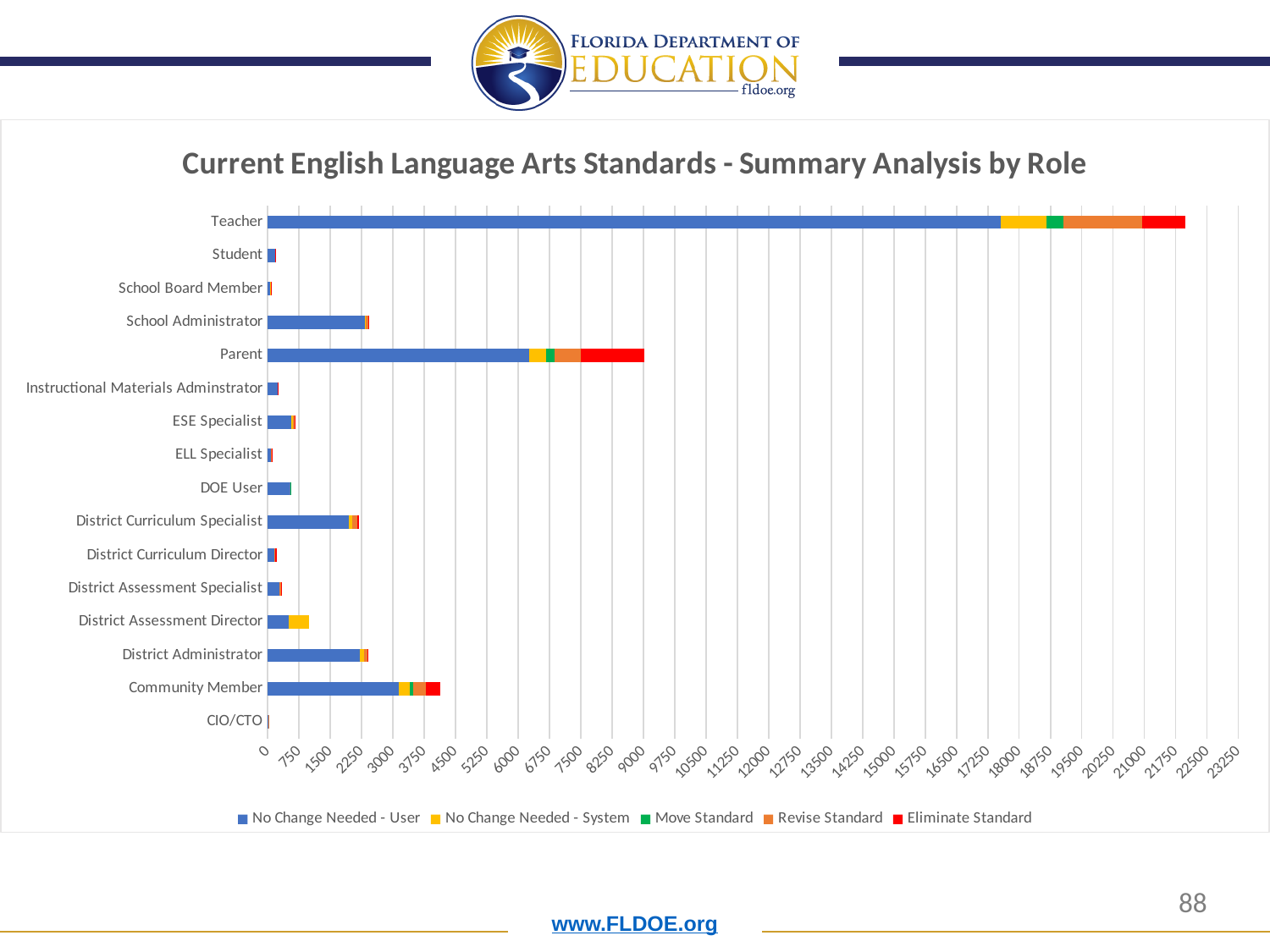
How many roles (categories) are listed on the vertical axis of the chart? 16 Which role has a longer total bar, School Administrator or District Assessment Director? School Administrator Which role has the longest total bar in the chart? Teacher Which role has the shortest total bar in the chart? CIO/CTO What is the title of the chart? Current English Language Arts Standards - Summary Analysis by Role Which role has a longer total bar, Parent or Community Member? Parent Which series is shown in red in the chart legend? Eliminate Standard Is the total bar length for Community Member greater or less than 4500? less Is the total bar length for Teacher greater or less than 18000? greater How many series does the chart legend list? 5 Is the total bar length for Parent greater or less than 7500? greater What kind of chart is shown on the slide? Stacked horizontal bar chart